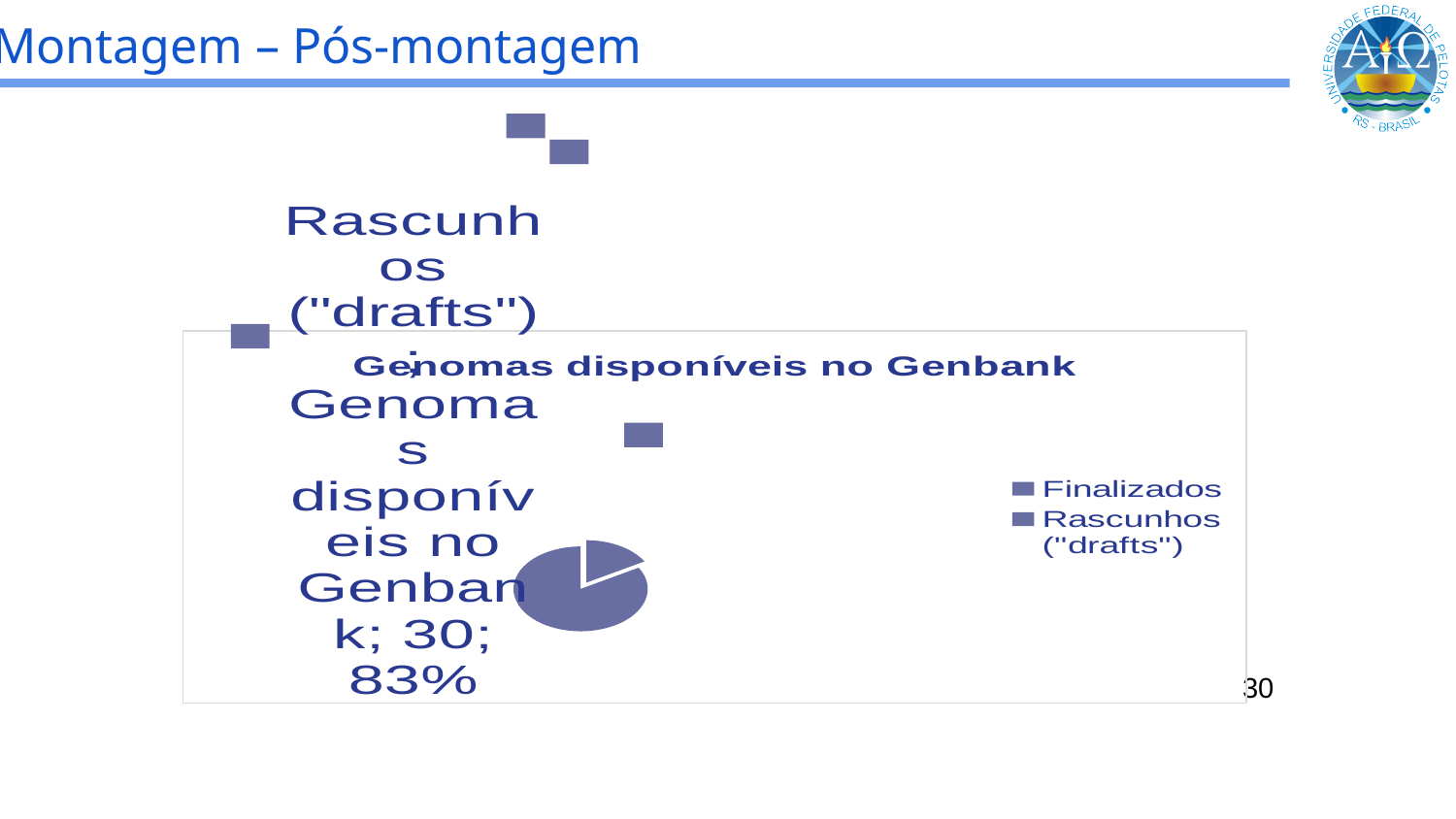
What value is printed for the Rascunhos ("drafts") slice? 30 Which category has the smallest slice of the pie? Finalizados What kind of chart is shown on the slide? pie chart What are the two legend entries of the chart? Finalizados; Rascunhos ("drafts") Which category has the largest slice of the pie? Rascunhos ("drafts") How many slices does the pie chart have? 2 How many entries does the chart's legend list? 2 Which slice is larger, Finalizados or Rascunhos ("drafts")? Rascunhos ("drafts") What is the title of the chart? Genomas disponíveis no Genbank What share of the pie does the Rascunhos ("drafts") slice represent? 83%